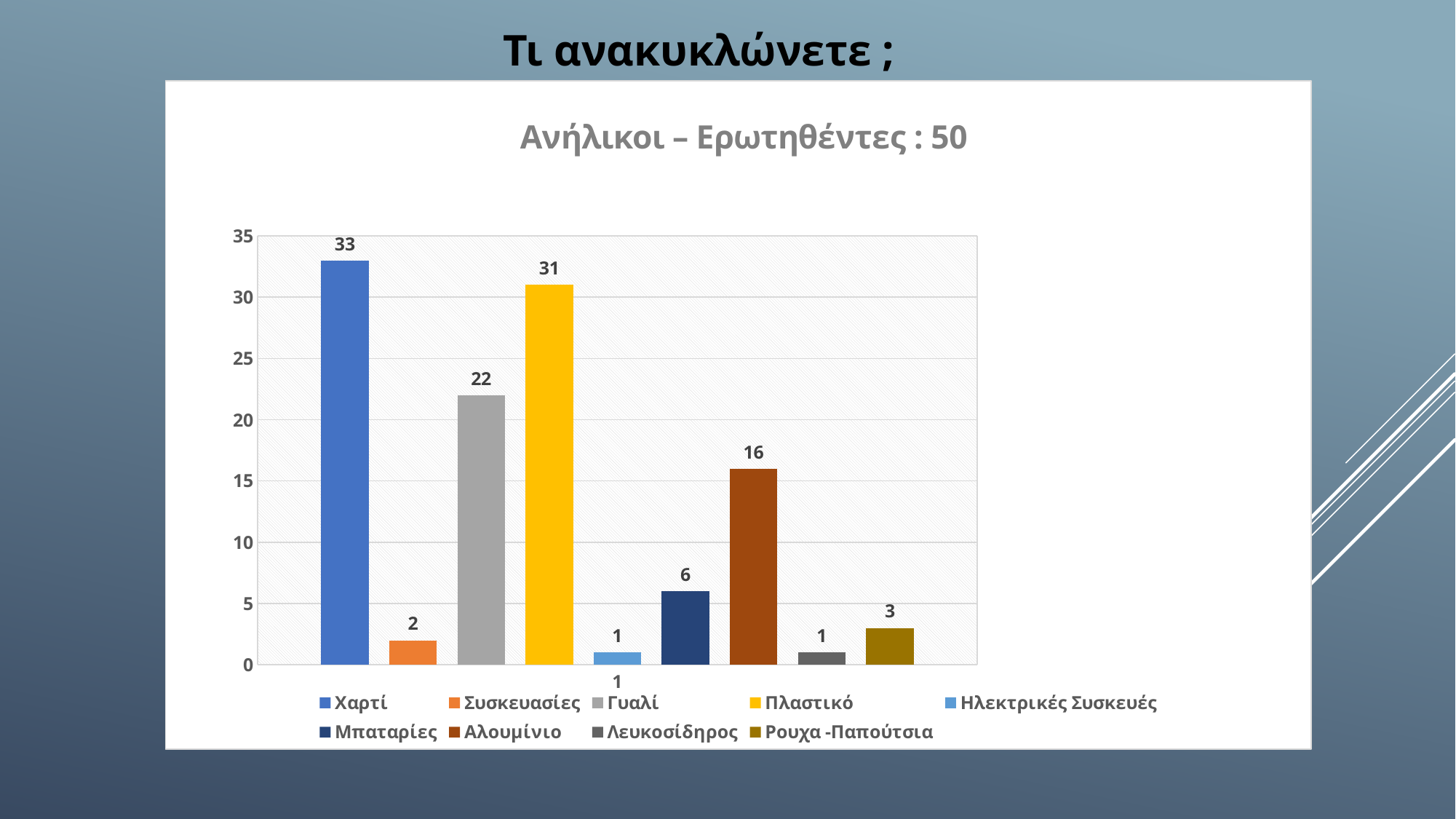
Which is larger, the value for Γυαλί or the value for Μπαταρίες? Γυαλί What is the title of the chart? Ανήλικοι – Ερωτηθέντες : 50 What is the difference between the values for Χαρτί and Πλαστικό? 2 What is the difference between the values for Γυαλί and Αλουμίνιο? 6 What kind of chart is shown on the slide? bar chart Which category has the highest value? Χαρτί What is the value for Πλαστικό? 31 What is the value for Μπαταρίες? 6 Is the value for Γυαλί greater or less than 20? greater How many series does the legend list? 9 What is the value for Αλουμίνιο? 16 What is the value for Χαρτί? 33